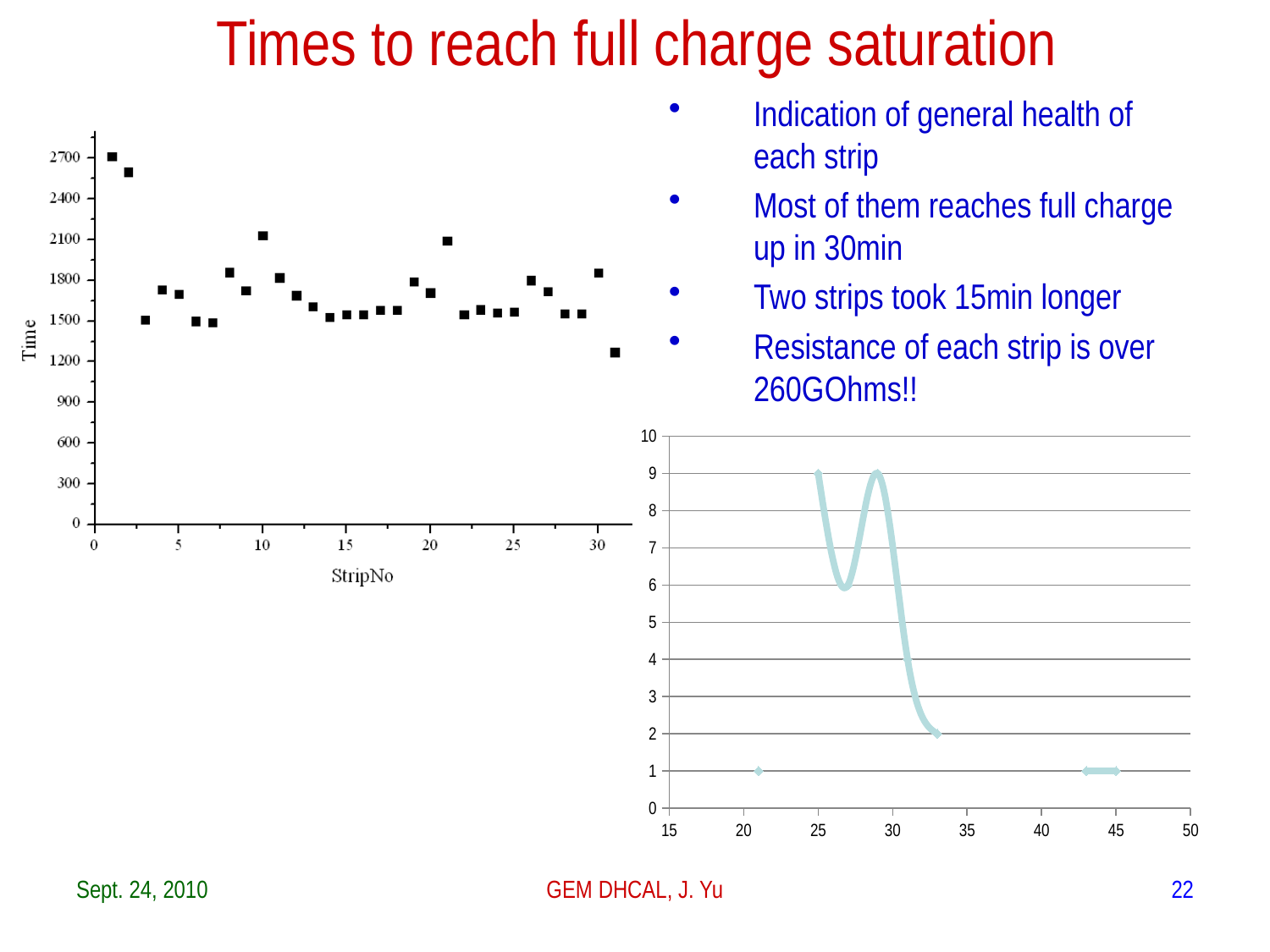
On the bottom-right chart, is the value at x = 27 greater or less than 5? greater On the left chart (Time vs StripNo), which strip has the highest time? 1 On the left chart (Time vs StripNo), which strip has the lowest time? 31 On the left chart (Time vs StripNo), what is the label of the x axis? StripNo On the left chart (Time vs StripNo), which has the larger time, strip 2 or strip 3? strip 2 On the left chart (Time vs StripNo), is the value for strip 31 greater or less than 1500? less On the left chart (Time vs StripNo), what is the label of the y axis? Time On the bottom-right chart, what is the y value of the point at x = 33? 2 On the left chart (Time vs StripNo), is the value for strip 10 greater or less than 1800? greater On the bottom-right chart, what is the y value of the point at x = 25? 9 What kind of chart is the left chart with the x axis labelled StripNo? scatter plot